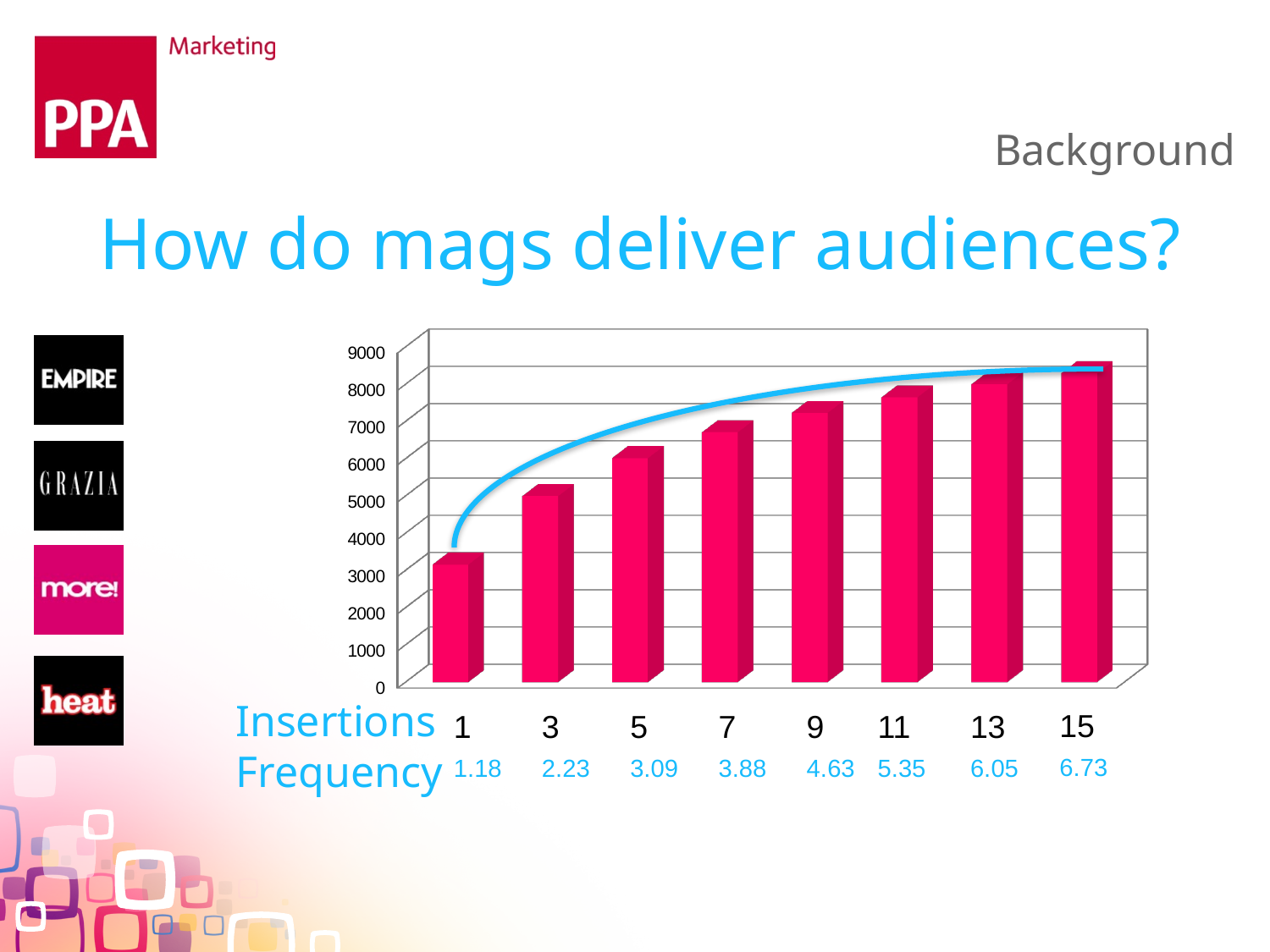
What is the difference between the frequency at 15 insertions and the frequency at 1 insertion? 5.55 Is the bar for 5 insertions greater or less than 5000? greater Which number of insertions has the tallest bar? 15 Is the bar for 15 insertions greater or less than 8000? greater How many bars are plotted in the chart? 8 What frequency is shown for 7 insertions? 3.88 Which number of insertions has the shortest bar? 1 What kind of chart is shown on the slide? bar chart Is the bar for 1 insertion greater or less than 4000? less Do the bar values rise or fall as the number of insertions increases? rise What frequency is shown for 15 insertions? 6.73